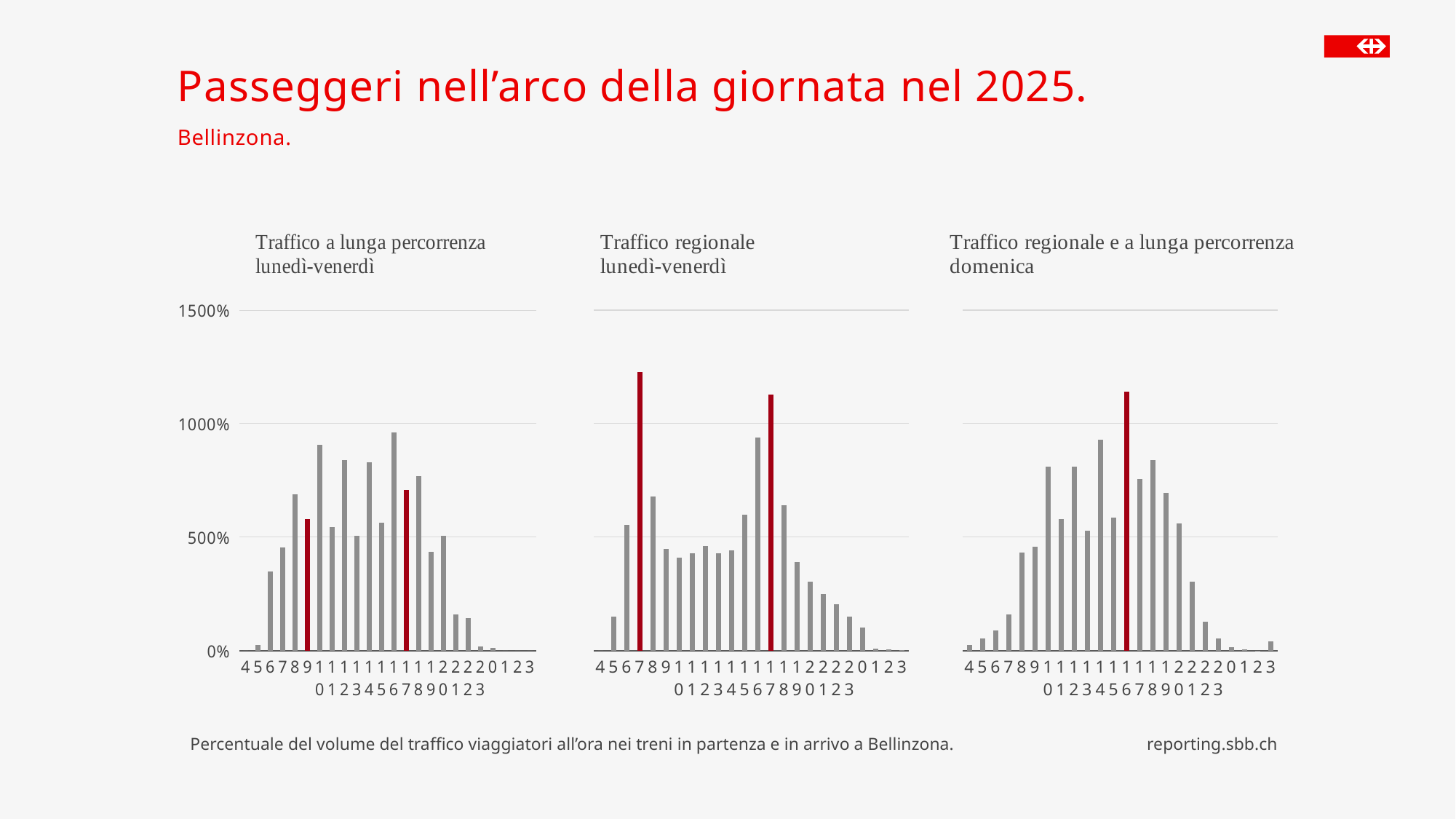
What kind of chart is used for 'Traffico a lunga percorrenza lunedì-venerdì'? bar chart What is the highest value shown on the y axis of the 'Traffico a lunga percorrenza lunedì-venerdì' chart? 1500% In the 'Traffico regionale e a lunga percorrenza domenica' chart, do the values rise or fall from hour 4 to hour 9? rise In the 'Traffico regionale lunedì-venerdì' chart, is the value for hour 23 greater or less than 500%? less How many charts are shown on the slide? 3 In the 'Traffico a lunga percorrenza lunedì-venerdì' chart, is the tallest bar greater or less than 1000%? less Which chart has the higher peak value: 'Traffico a lunga percorrenza lunedì-venerdì' or 'Traffico regionale lunedì-venerdì'? Traffico regionale lunedì-venerdì In the 'Traffico regionale e a lunga percorrenza domenica' chart, is the tallest bar greater or less than 1000%? greater In the 'Traffico regionale lunedì-venerdì' chart, do the values rise or fall from the afternoon peak toward hour 23? fall How many hourly categories does the 'Traffico regionale lunedì-venerdì' chart show on its x axis? 24